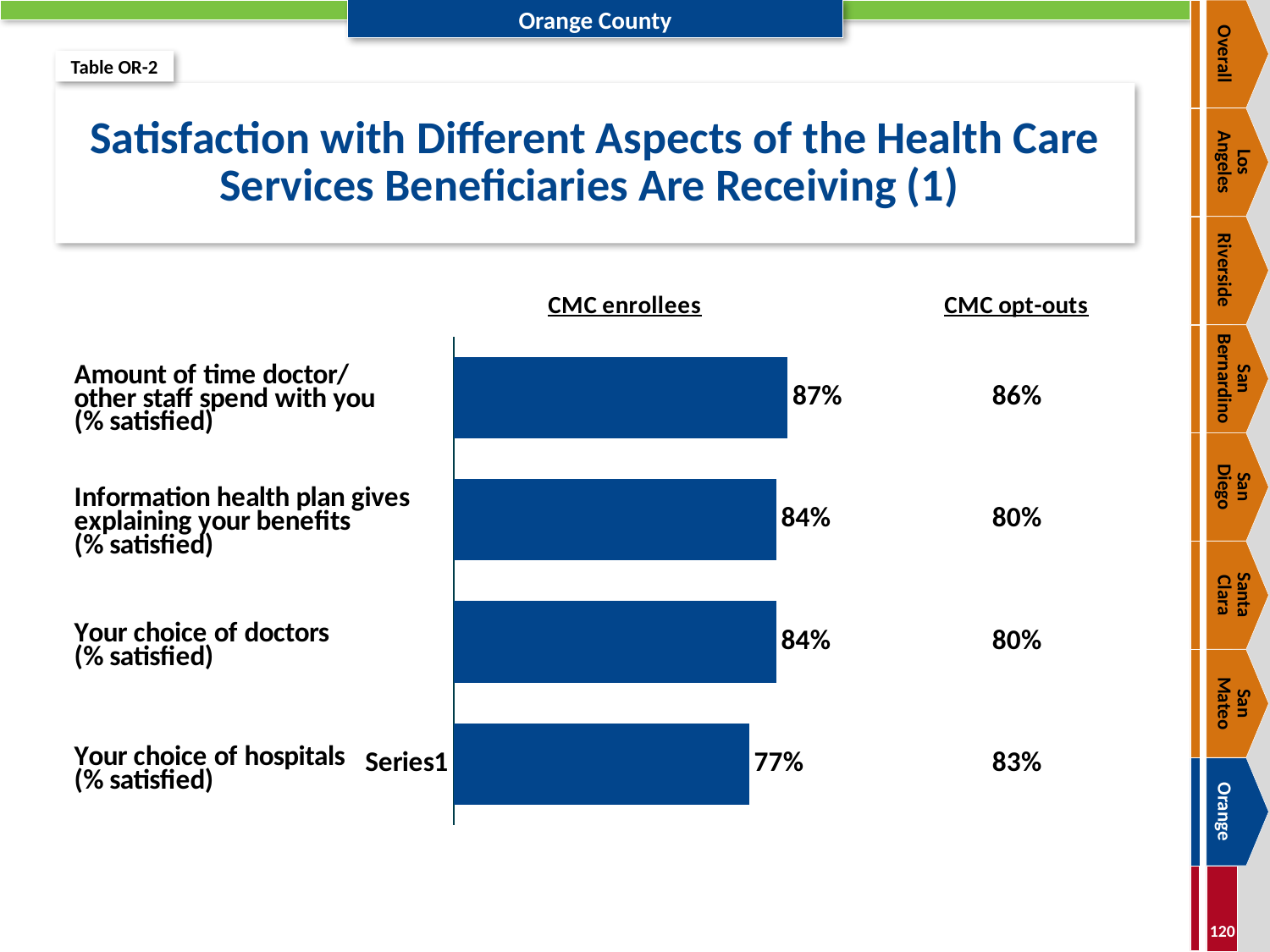
What kind of chart is shown on the slide? Bar chart What is the CMC enrollees value for 'Your choice of hospitals (% satisfied)'? 77% Which category has the lowest CMC enrollees bar? Your choice of hospitals (% satisfied) What is the title of the chart on the slide? Satisfaction with Different Aspects of the Health Care Services Beneficiaries Are Receiving (1) How many categories are plotted in the bar chart? 4 What is the CMC enrollees value for 'Amount of time doctor/other staff spend with you (% satisfied)'? 87% Which is larger for CMC enrollees: 'Information health plan gives explaining your benefits' or 'Your choice of hospitals'? Information health plan gives explaining your benefits What is the CMC enrollees value for 'Your choice of doctors (% satisfied)'? 84% What is the difference between the CMC enrollees values for 'Amount of time doctor/other staff spend with you' and 'Your choice of hospitals'? 10% What is the difference between the CMC enrollees and CMC opt-outs values for 'Your choice of doctors (% satisfied)'? 4% Which category has the highest CMC enrollees bar? Amount of time doctor/other staff spend with you (% satisfied) What is the CMC opt-outs value printed for 'Your choice of hospitals (% satisfied)'? 83%